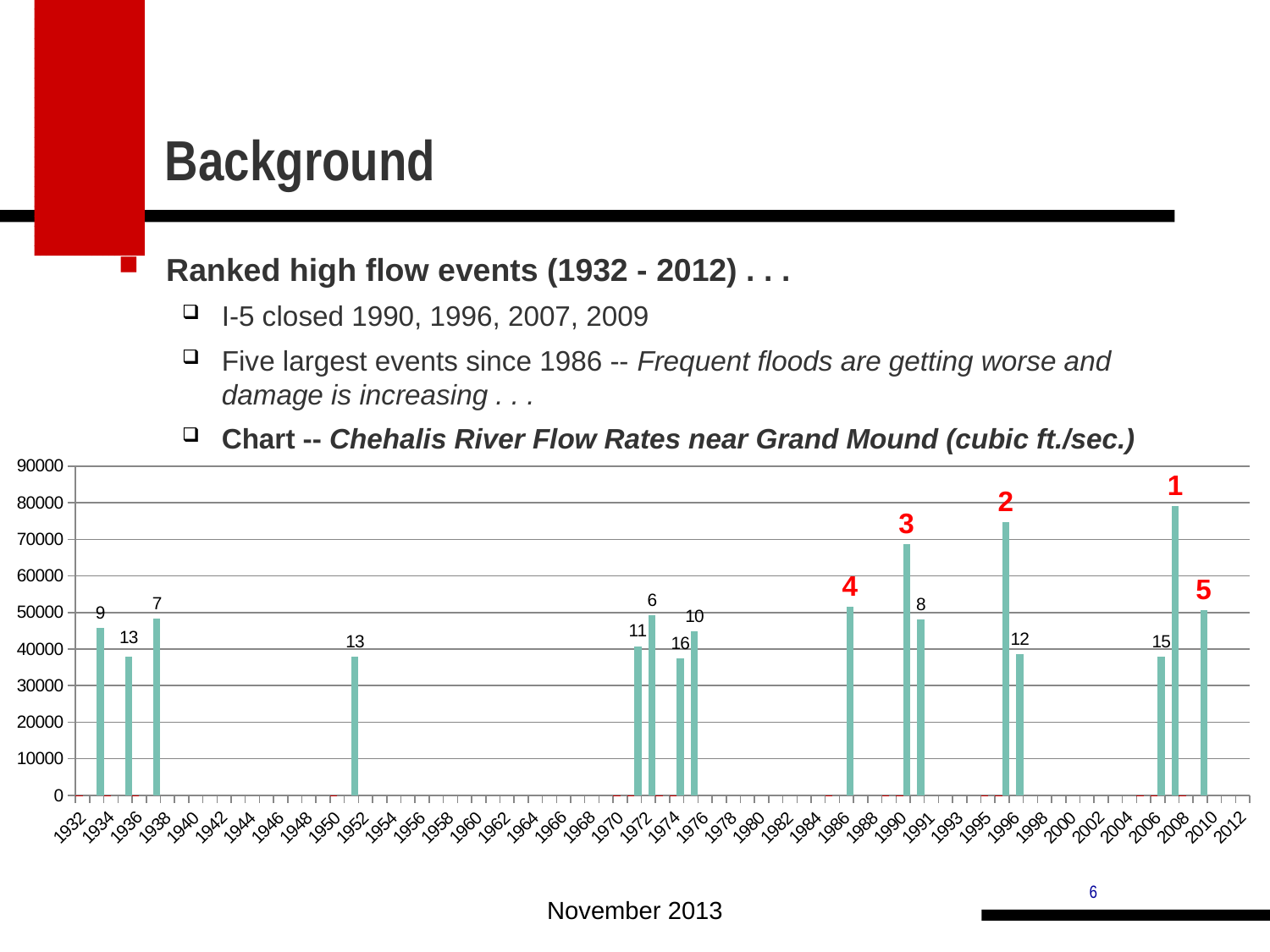
Which year has the larger flow rate, 1996 or 1990? 1996 How many bars with rank labels are plotted in the chart? 16 What rank label is printed above the bar for 2007? 1 Which year has the larger flow rate, 1937 or 1951? 1937 Is the flow rate for 1937 greater or less than 50000? less Which year has the highest flow rate in the chart? 2007 Is the flow rate for 1951 greater or less than 40000? less What rank label is printed above the bar for 1996? 2 What kind of chart is shown on the slide? bar chart What is the title of the chart as given on the slide? Chehalis River Flow Rates near Grand Mound (cubic ft./sec.) Is the flow rate for 2007 greater or less than 70000? greater What rank label is printed above the bar for 1990? 3